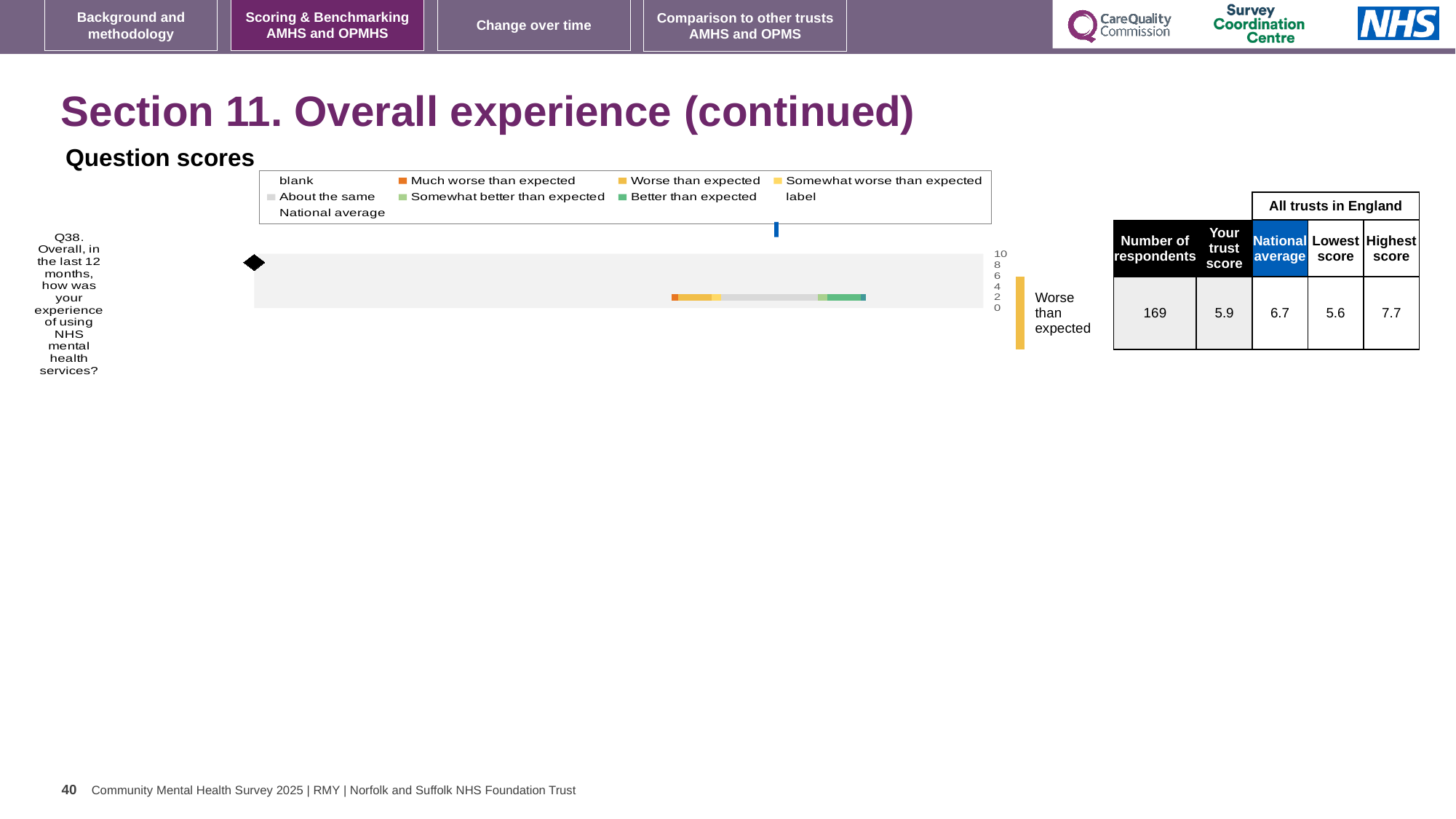
Which legend entry is shown in grey? About the same In the table beside the chart, what is your trust score for Q38? 5.9 What rating label is printed to the right of the chart for Q38? Worse than expected What is the highest tick value shown on the chart's axis? 10 In the table beside the chart, which is larger for Q38: the trust score or the national average? national average Which question number is plotted in the chart? Q38 What kind of chart is shown under 'Question scores'? bar chart In the table beside the chart, what is the number of respondents for Q38? 169 How many survey questions are plotted in the chart? 1 In the table beside the chart, what is the national average for Q38? 6.7 Which legend entry is shown in orange? Much worse than expected How many legend entries are shown with a coloured marker? 6